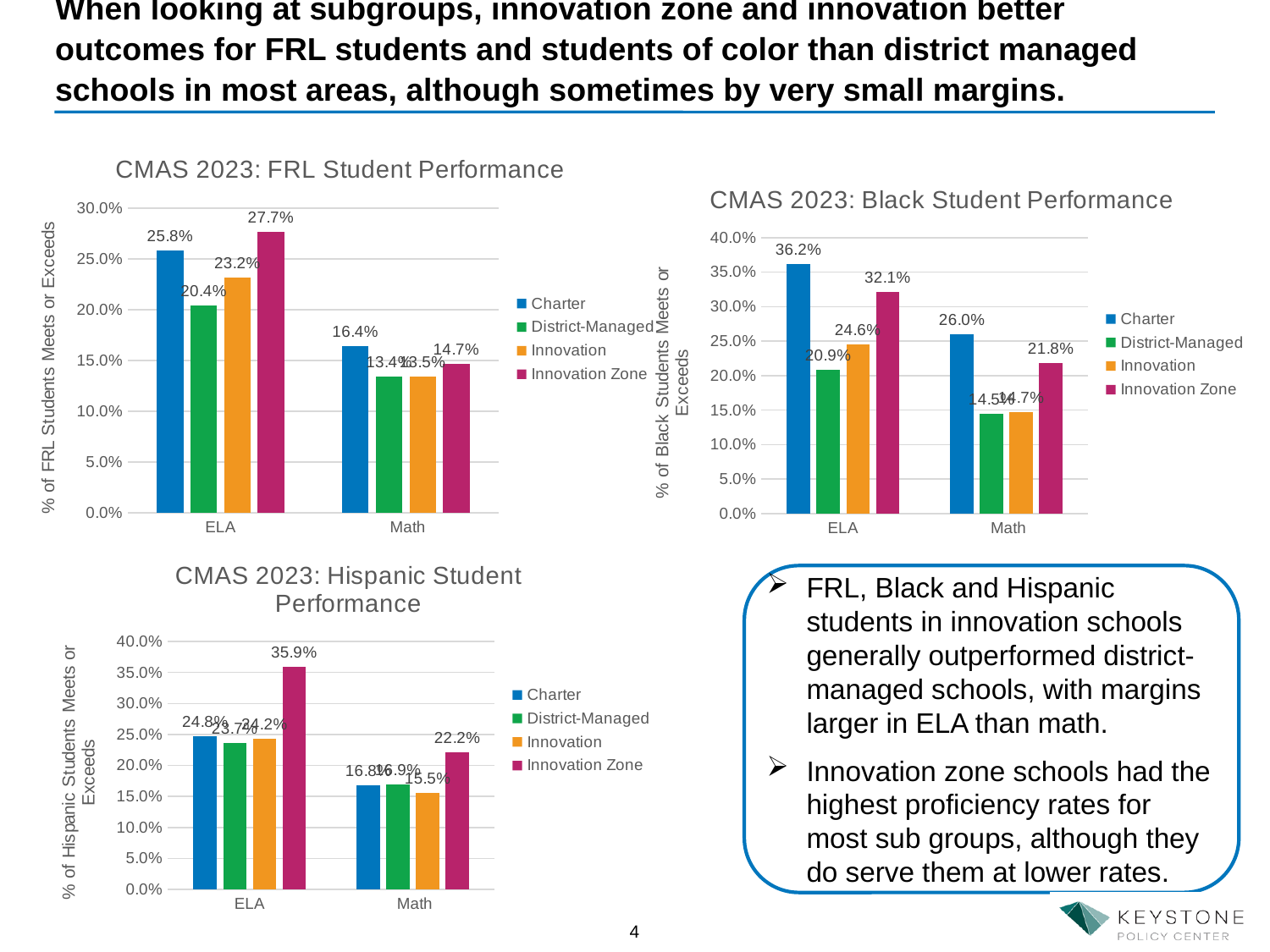
In the CMAS 2023: FRL Student Performance chart, what is the value for Innovation Zone in ELA? 27.7% In the CMAS 2023: Black Student Performance chart, which school type has the lowest ELA value? District-Managed In the CMAS 2023: FRL Student Performance chart, what is the value for Charter in Math? 16.4% In the CMAS 2023: Hispanic Student Performance chart, what is the value for Innovation Zone in ELA? 35.9% In the CMAS 2023: FRL Student Performance chart, what is the difference between the Charter and District-Managed ELA values? 5.4% In the CMAS 2023: FRL Student Performance chart, which school type has the highest ELA value? Innovation Zone In the CMAS 2023: Black Student Performance chart, is the Charter ELA value greater or less than 35.0%? greater In the CMAS 2023: Hispanic Student Performance chart, which is larger, the Innovation Zone Math value or the Innovation Math value? Innovation Zone In the CMAS 2023: Black Student Performance chart, what is the value for Innovation Zone in Math? 21.8% What type of chart is the CMAS 2023: FRL Student Performance chart? Bar chart In the CMAS 2023: Black Student Performance chart, what is the value for Charter in ELA? 36.2% How many series does the legend list in the CMAS 2023: Hispanic Student Performance chart? 4